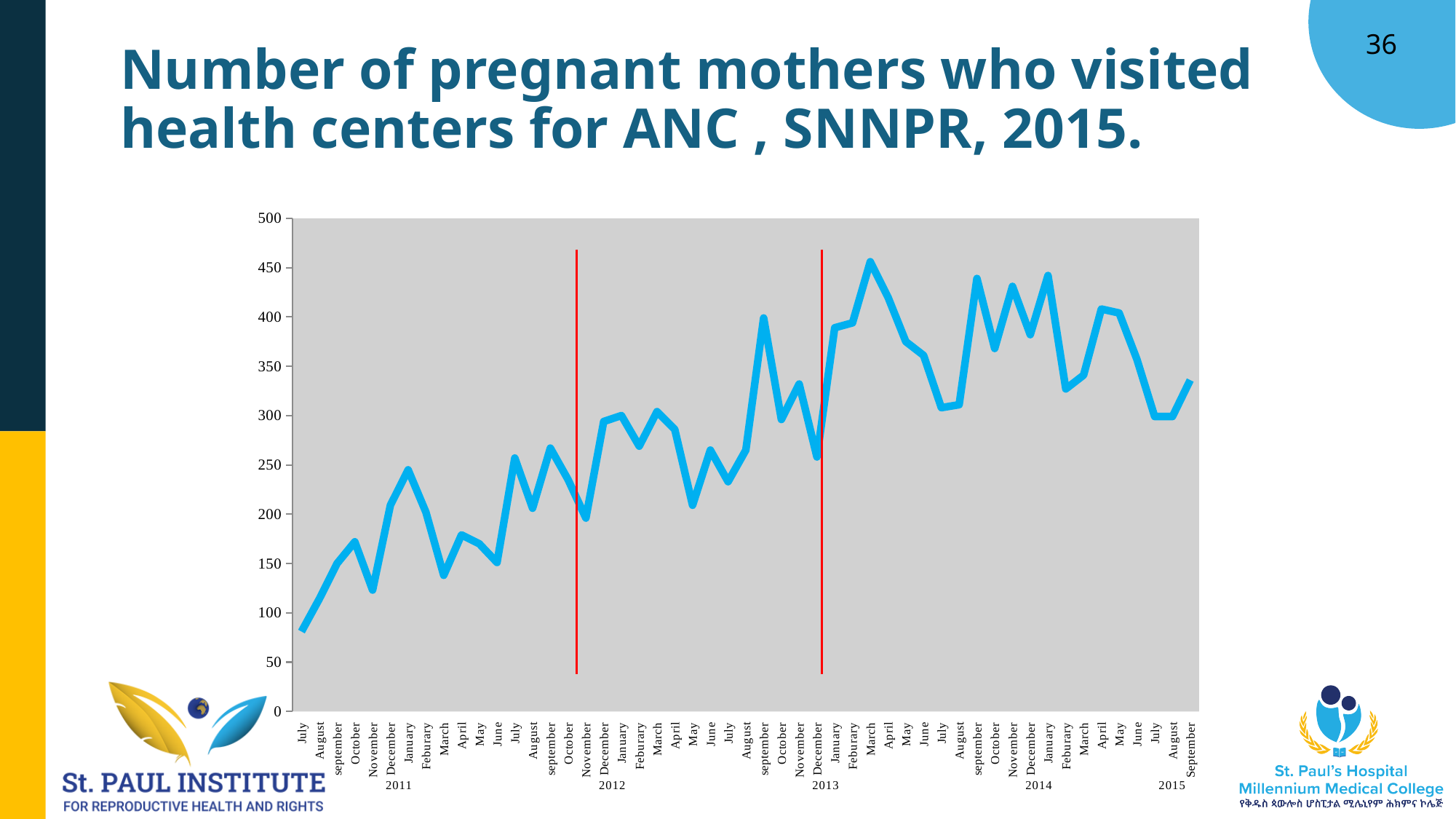
Which is larger, the value for December 2013 or the value for January 2014? January 2014 Which month has the highest number of pregnant mothers visiting health centers for ANC? March 2013 How many red vertical lines are drawn on the chart? 2 Is the value for December 2013 greater or less than 300? less What kind of chart is shown on the slide? line chart Which is larger, the value for September 2013 or the value for October 2013? September 2013 Overall, does the number of ANC visits rise or fall from July 2011 to September 2015? rise Is the value for July 2011 greater or less than 100? less Which month has the lowest number of pregnant mothers visiting health centers for ANC? July 2011 Is the value for November 2011 greater or less than 150? less